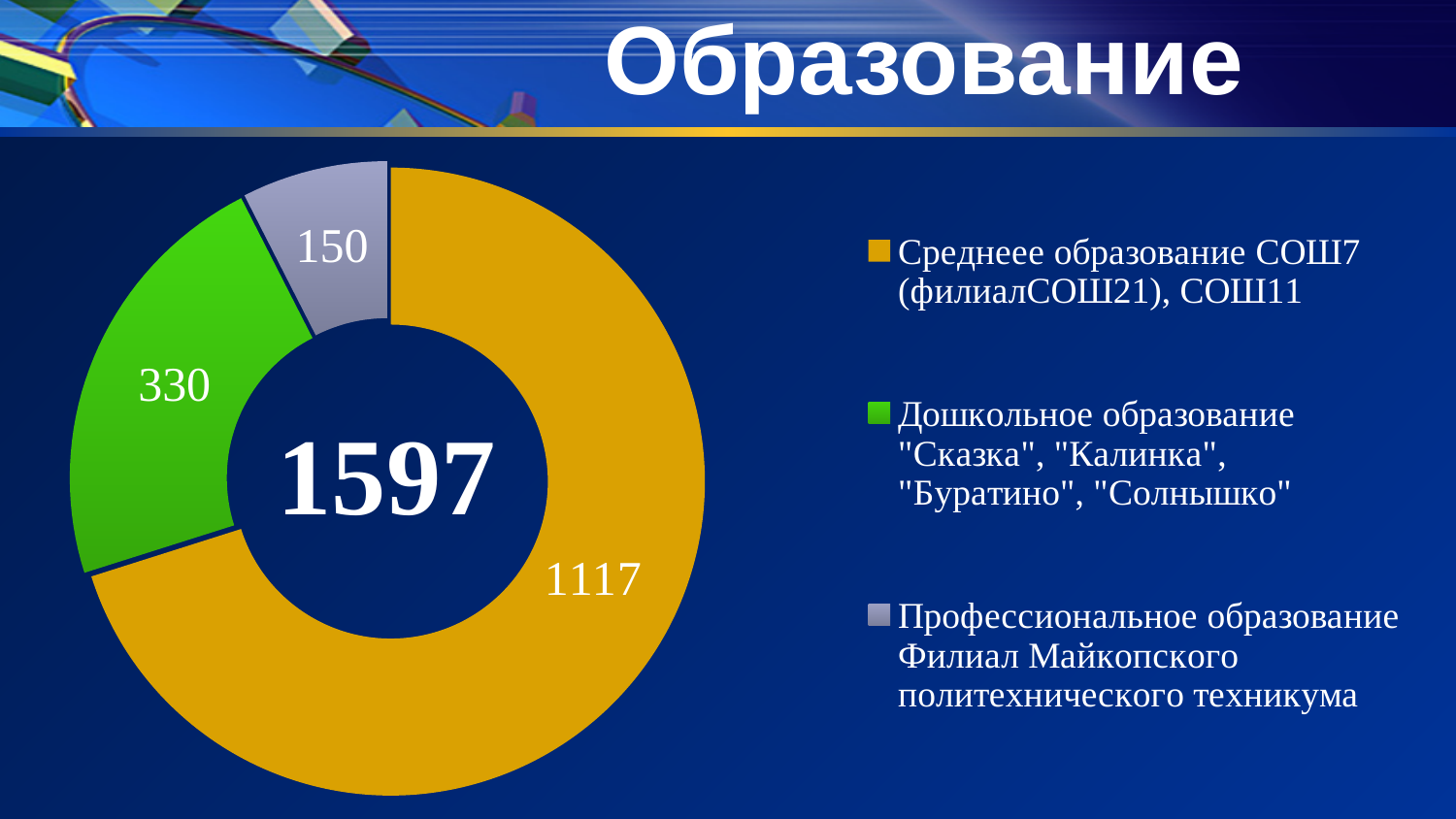
What is the difference between the values for Дошкольное образование and Профессиональное образование? 180 What colour is the slice for Дошкольное образование? Green How many categories does the chart show? 3 What kind of chart is shown on the slide? Doughnut (pie) chart Which category has the smallest value? Профессиональное образование Which category has the largest value? Среднее образование What is the difference between the values for Среднее образование and Дошкольное образование? 787 What is the value for Профессиональное образование? 150 What is the value for Среднее образование (СОШ7, СОШ11)? 1117 Which is larger, the value for Дошкольное образование or Профессиональное образование? Дошкольное образование What total number is shown in the centre of the chart? 1597 What is the value for Дошкольное образование? 330